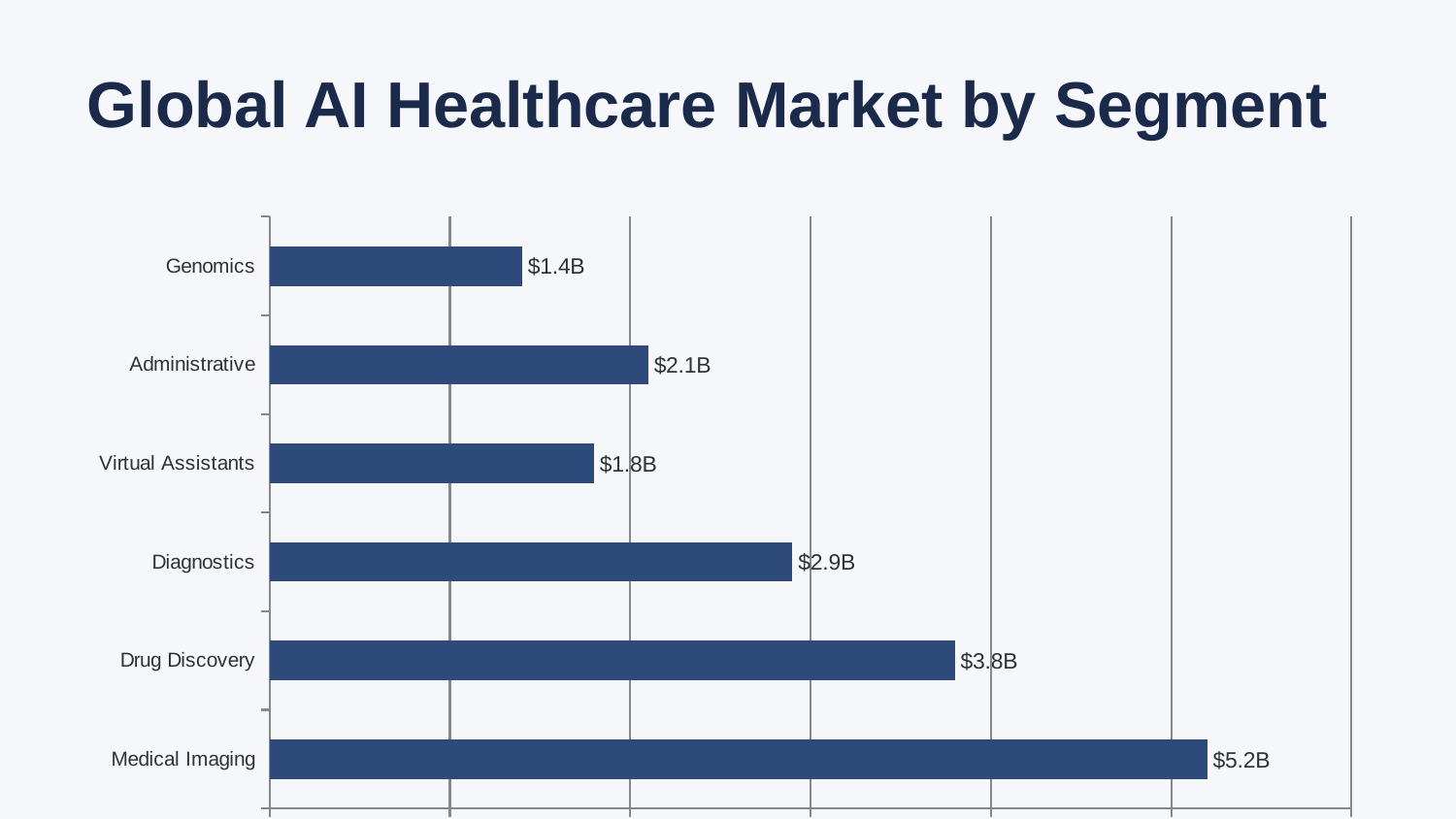
Which segment has the highest value? Medical Imaging Which segment has the lowest value? Genomics What is the value for Genomics? $1.4B What kind of chart is shown on the slide? Bar chart What is the value for Diagnostics? $2.9B What is the difference between Administrative and Virtual Assistants? $0.3B What is the value for Virtual Assistants? $1.8B How many segments are shown in the chart? 6 What is the title of the chart? Global AI Healthcare Market by Segment What is the difference between Medical Imaging and Drug Discovery? $1.4B Which is larger, Diagnostics or Administrative? Diagnostics What is the value for Medical Imaging? $5.2B